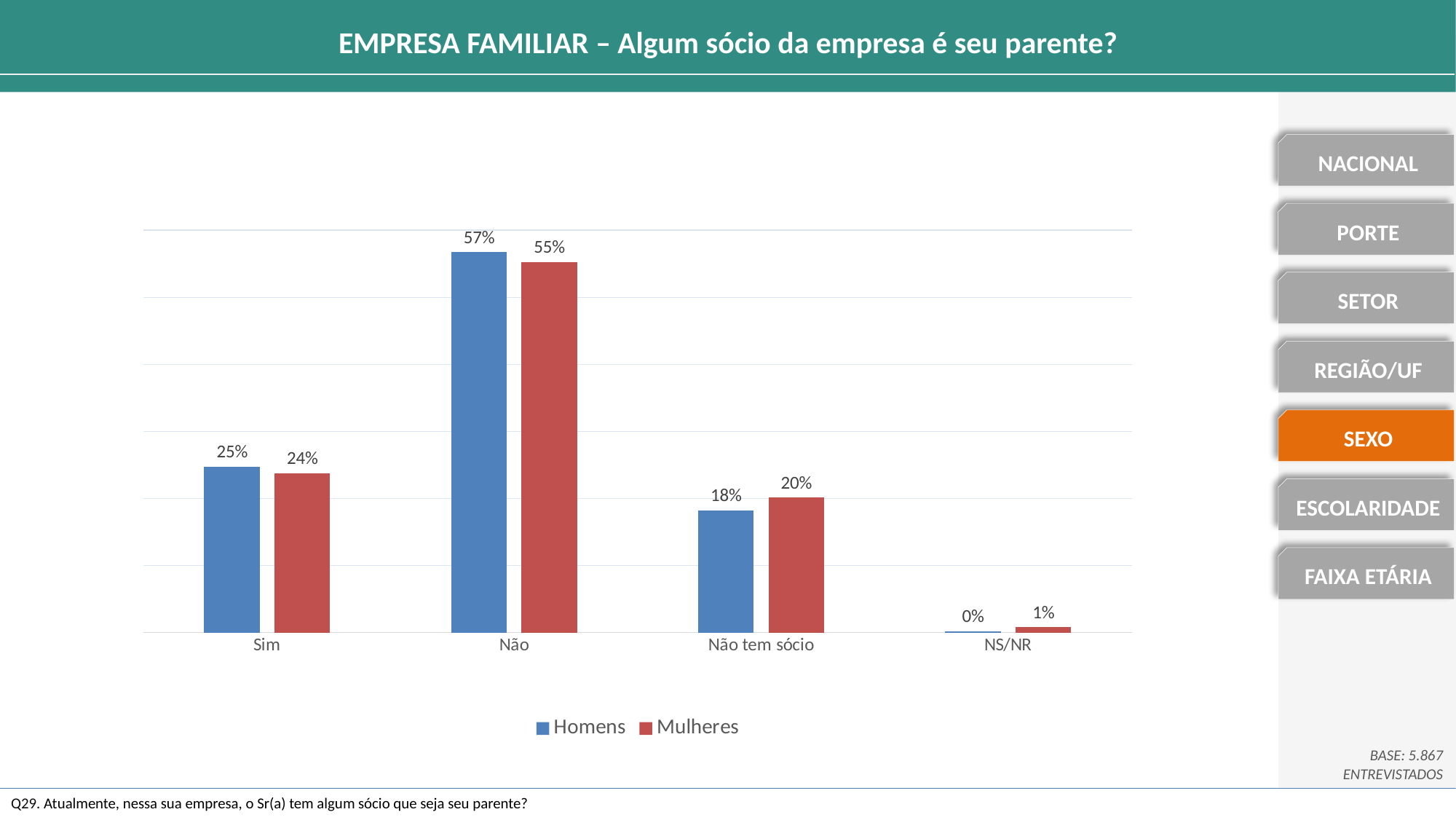
What is the value for Homens in the Não category? 57% What is the value for Homens in the NS/NR category? 0% What is the value for Mulheres in the Sim category? 24% Which series is shown in red in the legend? Mulheres What is the value for Mulheres in the Não tem sócio category? 20% Which category has the lowest value for Mulheres? NS/NR What is the difference between Homens and Mulheres in the Não category? 2% How many categories are shown on the x axis? 4 Which is larger in the Não tem sócio category, Homens or Mulheres? Mulheres What kind of chart is shown on the slide? Bar chart How many series does the legend list? 2 Which category has the highest value for Homens? Não